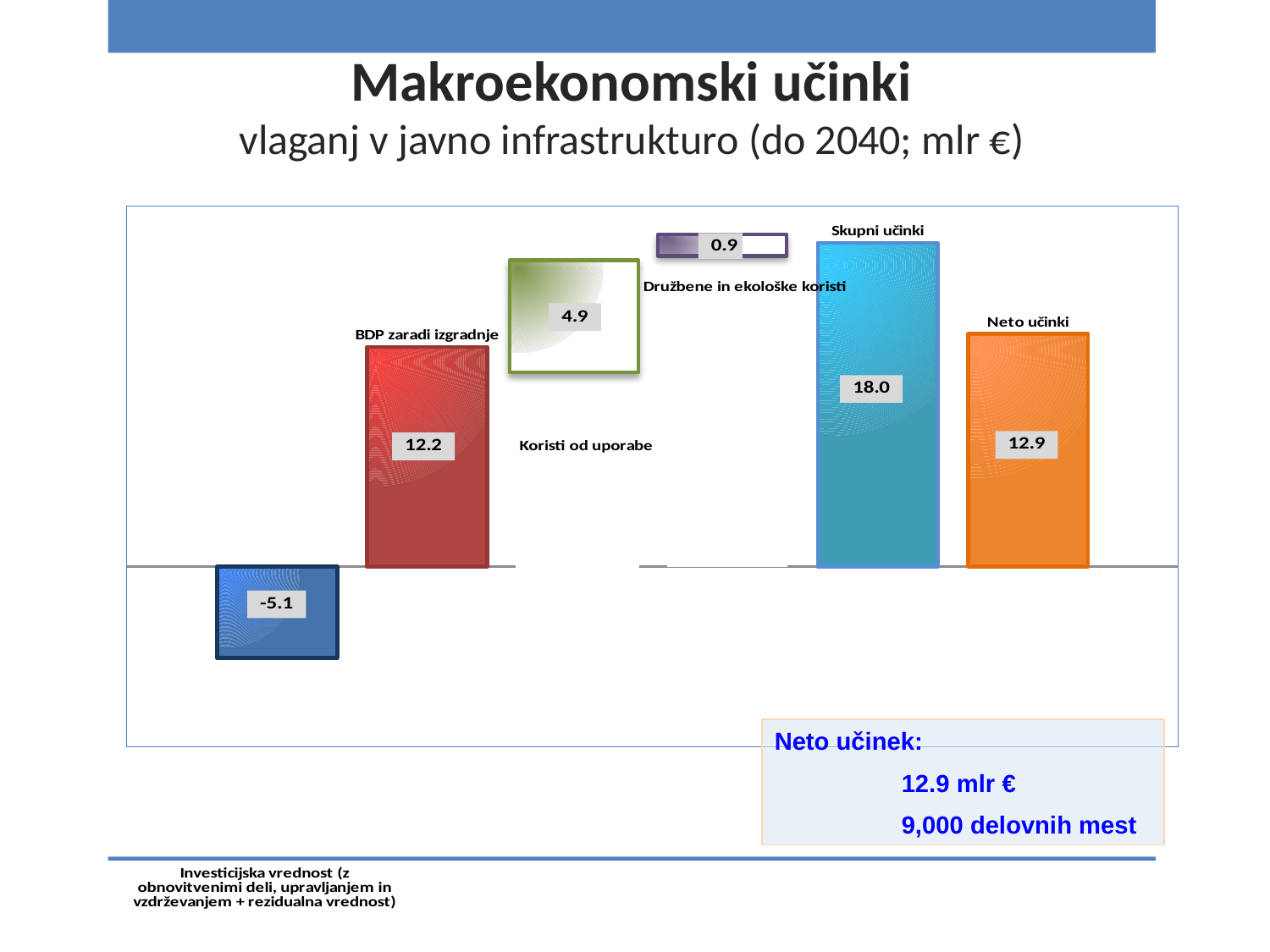
What is the value for Investicijska vrednost (z obnovitvenimi deli, upravljanjem in vzdrževanjem + rezidualna vrednost)? -5.1 What kind of chart is shown on the slide? Bar chart Which category has the highest value? Skupni učinki What is the value for Koristi od uporabe? 4.9 What is the value for Neto učinki? 12.9 What is the value for Družbene in ekološke koristi? 0.9 What is the difference between Skupni učinki and Neto učinki? 5.1 What is the value for Skupni učinki? 18.0 What is the value for BDP zaradi izgradnje? 12.2 Which is larger, BDP zaradi izgradnje or Koristi od uporabe? BDP zaradi izgradnje How many bars are plotted in the chart? 6 Which category has the lowest value? Investicijska vrednost (z obnovitvenimi deli, upravljanjem in vzdrževanjem + rezidualna vrednost)